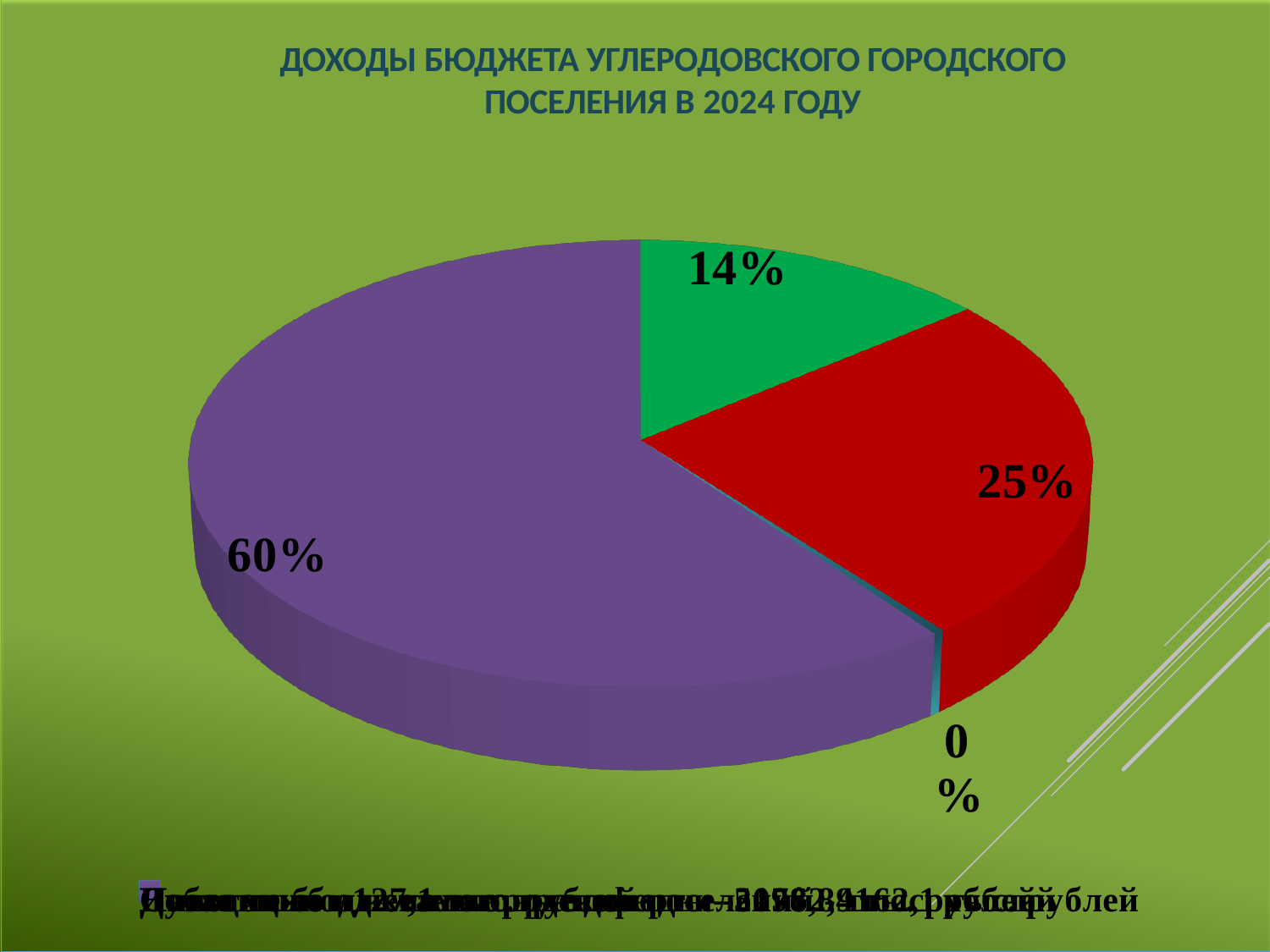
What share of the pie does the purple slice represent? 60% What share of the pie does the red slice represent? 25% What is the smallest percentage shown on the pie chart? 0% What kind of chart is shown on the slide? pie chart What is the difference in percentage points between the red slice and the green slice? 11 What share of the pie does the green slice represent? 14% Which colour slice is the largest on the pie chart? purple Which is larger, the red slice or the green slice? red slice What is the title of the chart? ДОХОДЫ БЮДЖЕТА УГЛЕРОДОВСКОГО ГОРОДСКОГО ПОСЕЛЕНИЯ В 2024 ГОДУ What is the largest percentage shown on the pie chart? 60% How many slices are labelled with percentages on the pie chart? 4 What is the difference in percentage points between the purple slice and the red slice? 35